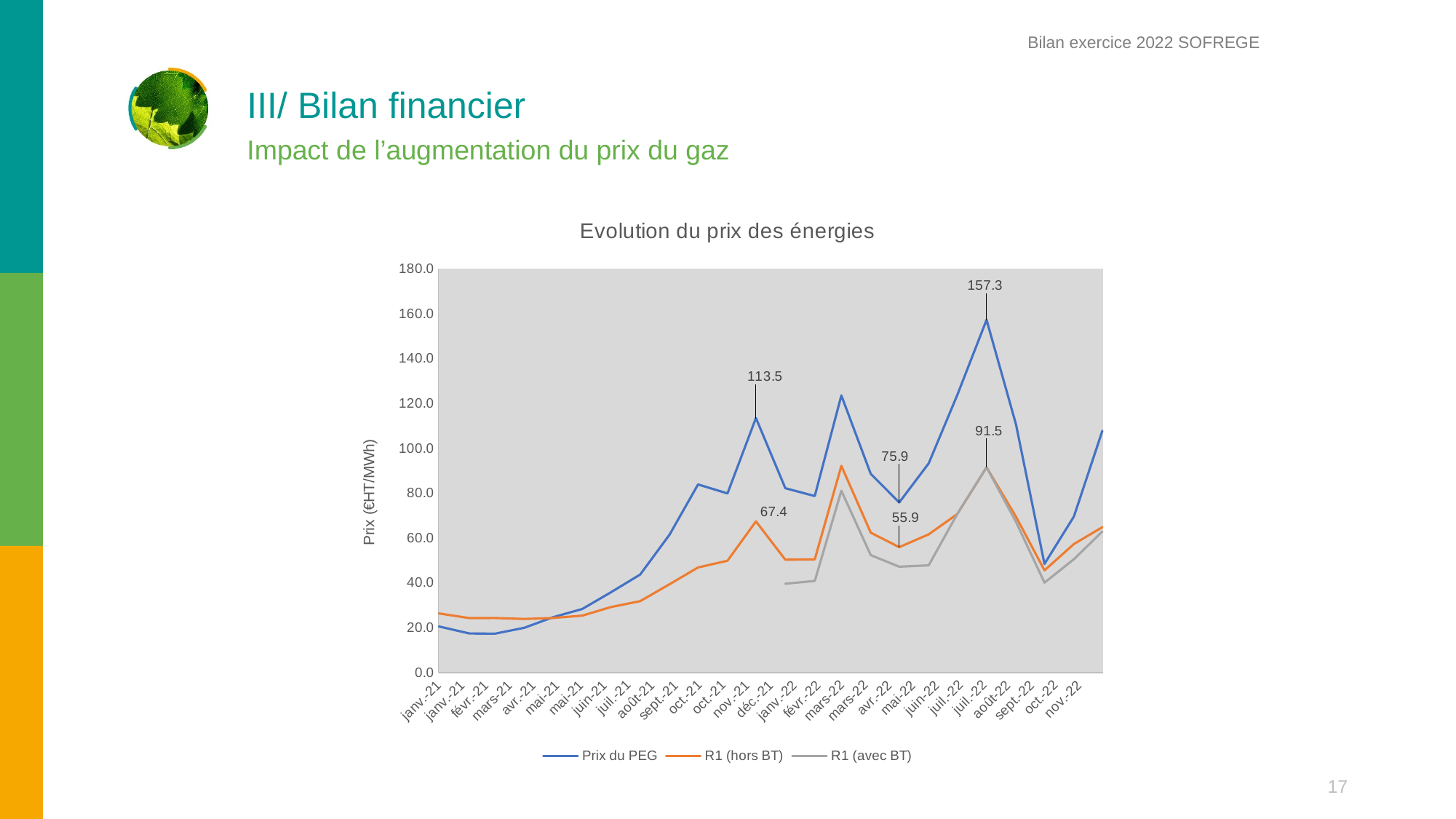
What type of chart is shown on the slide? line chart Which series reaches the highest value on the chart? Prix du PEG How many series does the legend of the chart list? 3 What is the title of the vertical axis of the chart? Prix (€HT/MWh)